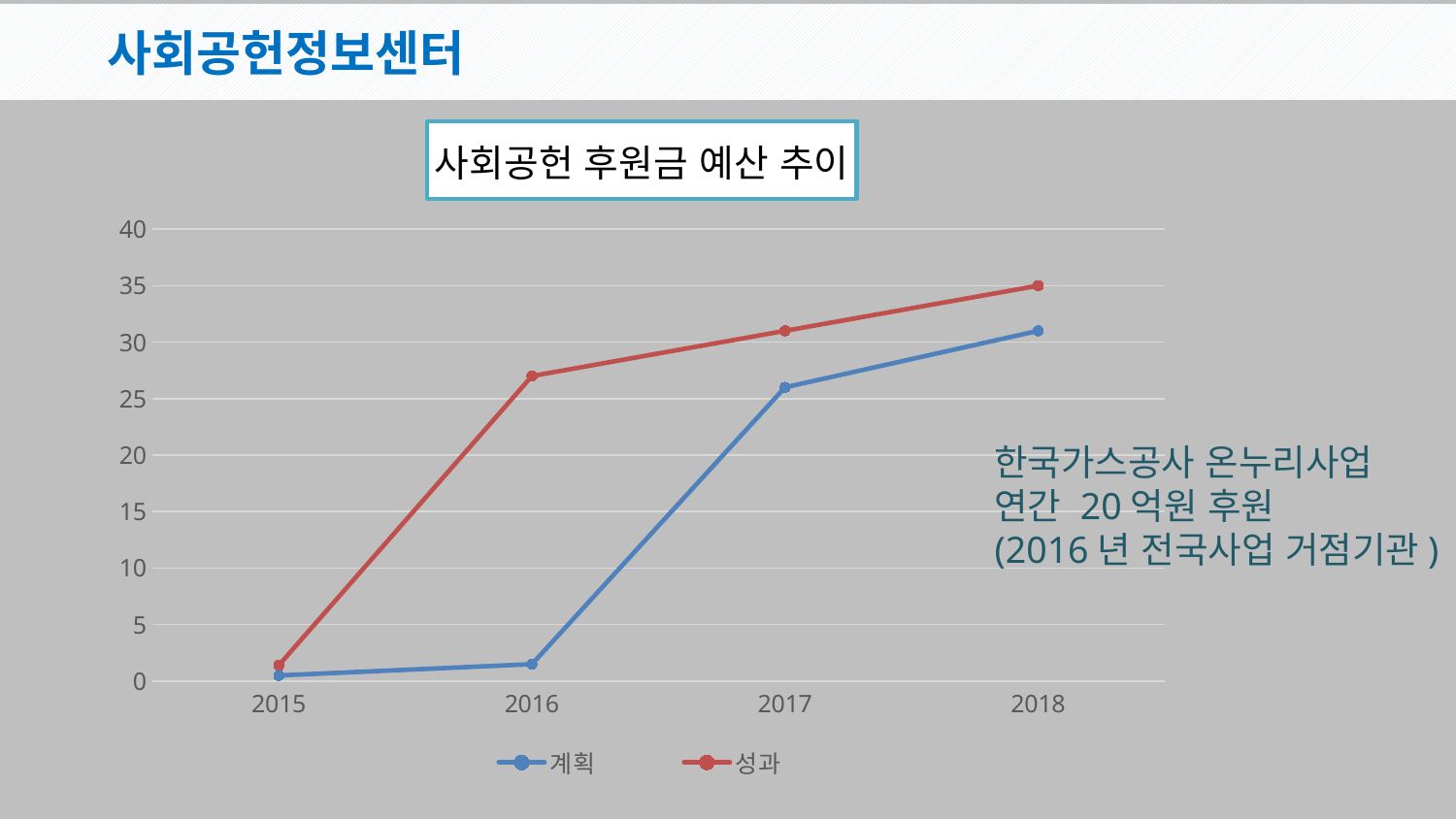
What kind of chart is shown on the slide? line chart Is the 성과 value for 2016 greater or less than 25? greater What colour is the line for the 성과 series? red In which year is the 성과 series at its highest? 2018 In 2017, which series has the larger value, 계획 or 성과? 성과 Is the 계획 value for 2016 greater or less than 5? less How many series does the legend list? 2 Does the 성과 series rise or fall from 2015 to 2018? rise In which year is the 계획 series at its lowest? 2015 Is the 계획 value for 2017 greater or less than 20? greater What is the title of the chart? 사회공헌 후원금 예산 추이 How many years are plotted along the x axis? 4